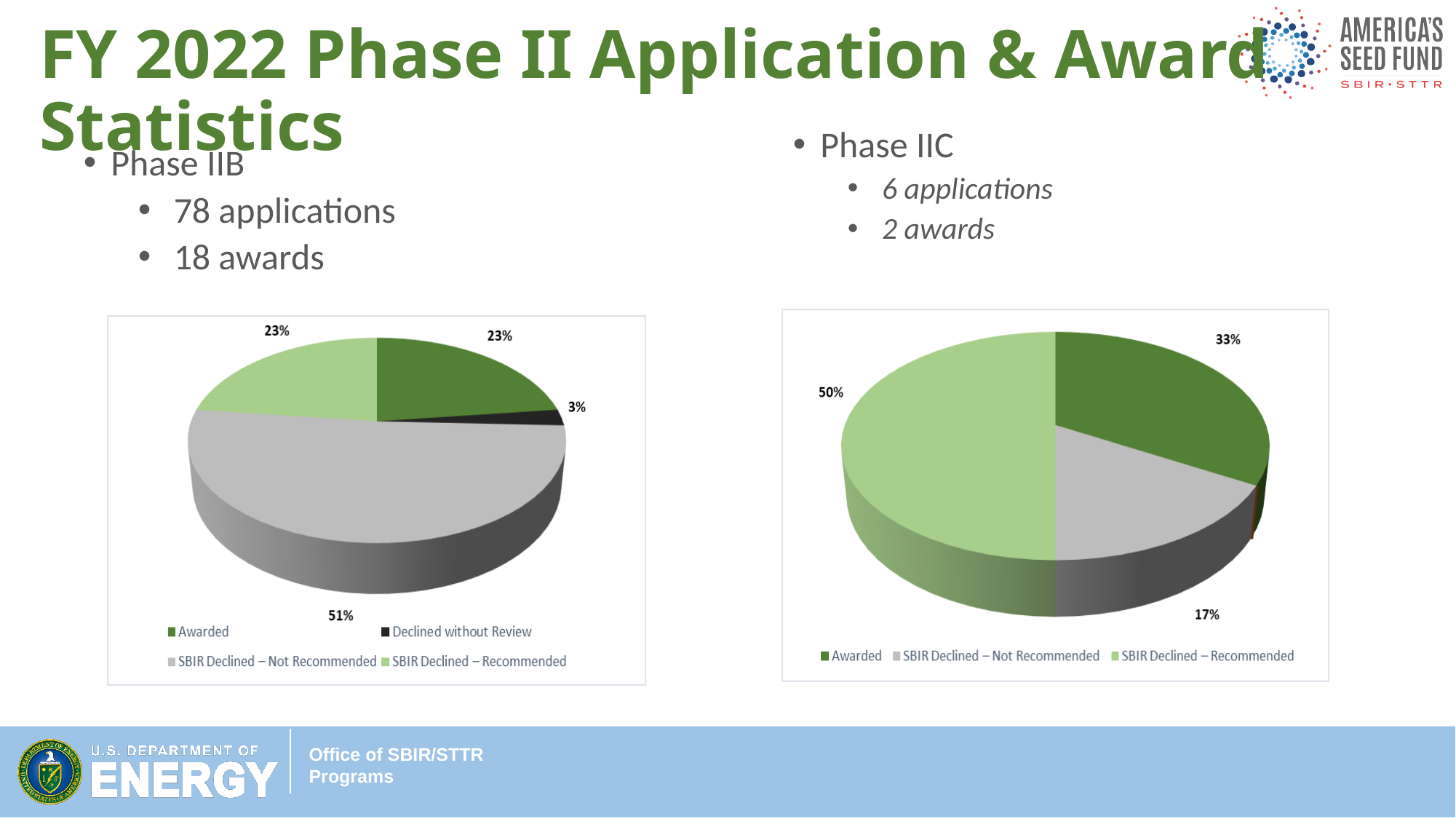
In the right pie chart (Phase IIC), what share is labelled for SBIR Declined – Recommended? 50% In the right pie chart (Phase IIC), which is larger: the Awarded share or the SBIR Declined – Not Recommended share? Awarded In the left pie chart (Phase IIB), what is the difference between the SBIR Declined – Not Recommended share and the Awarded share? 28 percentage points In the right pie chart (Phase IIC), what share is labelled for Awarded? 33% In the left pie chart (Phase IIB), what share is labelled for SBIR Declined – Not Recommended? 51% In the left pie chart (Phase IIB), which category has the smallest slice? Declined without Review In the left pie chart (Phase IIB), how many categories does the legend list? 4 What type of chart is used for the Phase IIC statistics on the right? Pie chart In the left pie chart (Phase IIB), what share is labelled for Declined without Review? 3% In the right pie chart (Phase IIC), how many categories does the legend list? 3 In the right pie chart (Phase IIC), which category has the smallest slice? SBIR Declined – Not Recommended In the left pie chart (Phase IIB), which category has the largest slice? SBIR Declined – Not Recommended